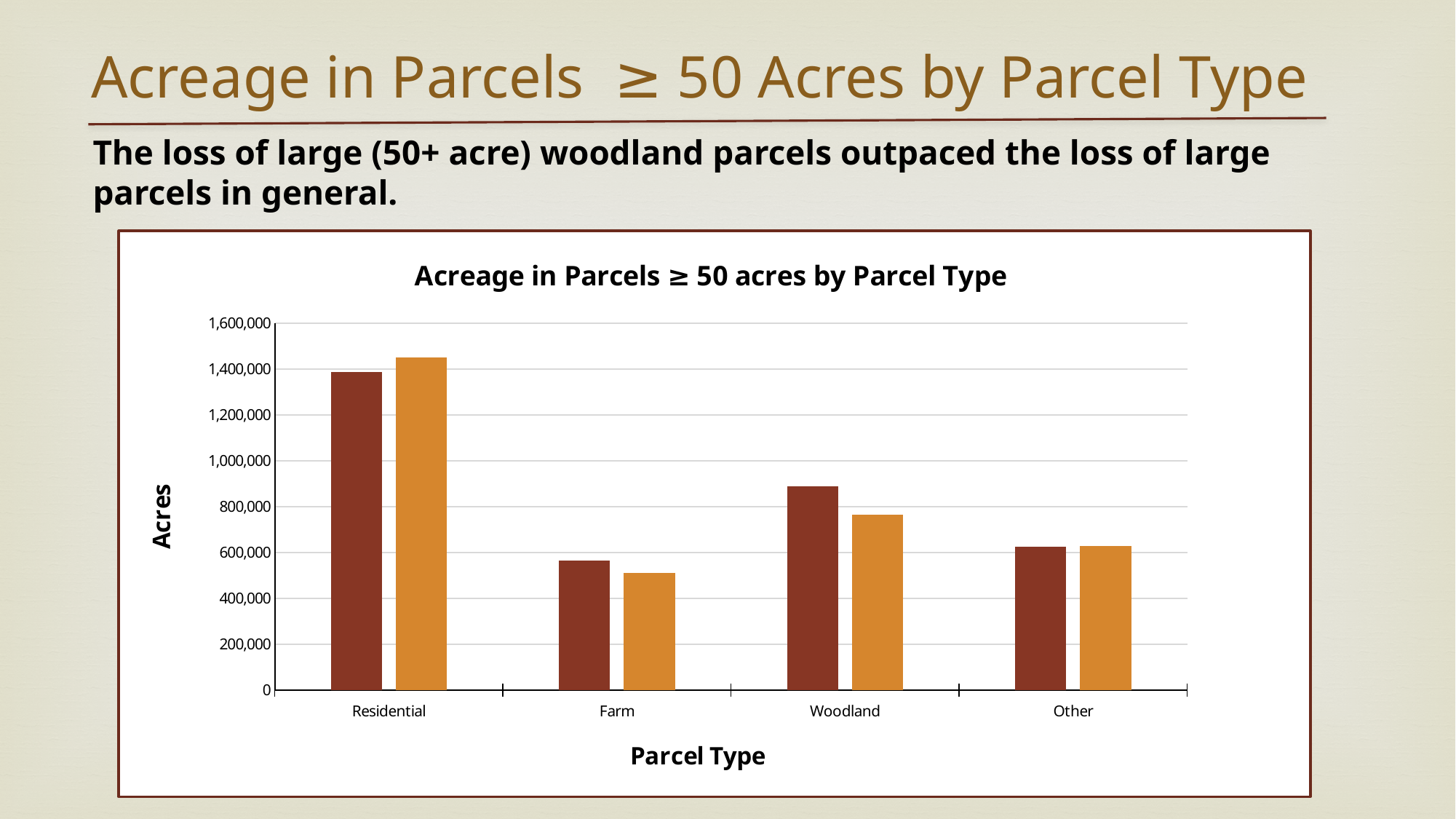
Which parcel type has the tallest dark brown bar? Residential What kind of chart is shown on the slide? bar chart Is the orange bar for Woodland greater or less than 800,000 acres? less What is the title of the chart? Acreage in Parcels ≥ 50 acres by Parcel Type Is the dark brown bar for Residential greater or less than 1,200,000 acres? greater Is the dark brown bar for Woodland greater or less than 1,000,000 acres? less For Residential, which bar is taller, the dark brown bar or the orange bar? the orange bar For Woodland, which bar is taller, the dark brown bar or the orange bar? the dark brown bar What is the label on the vertical axis of the chart? Acres How many parcel type categories are shown on the x axis? 4 Which parcel type has the shortest orange bar? Farm